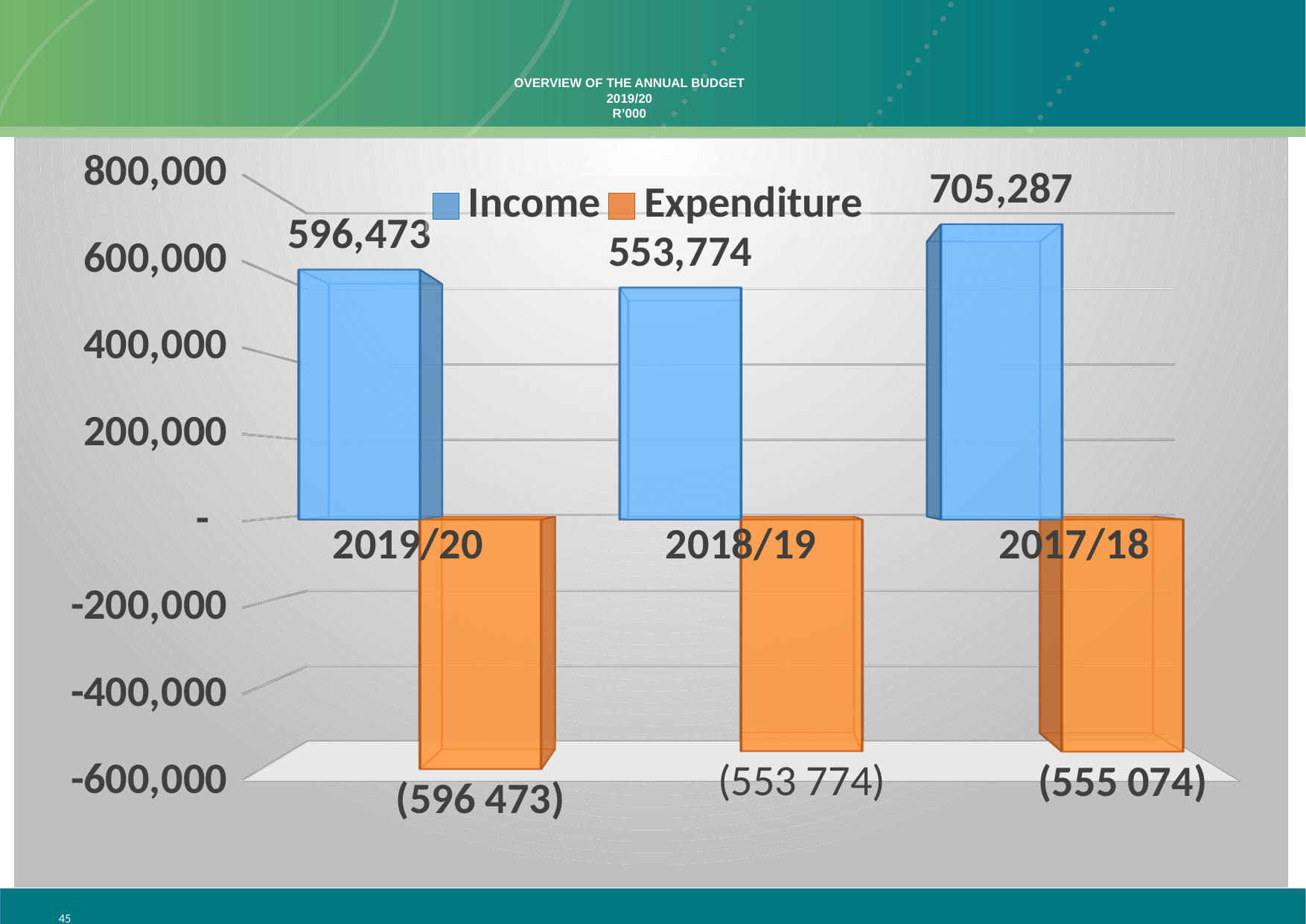
How many series does the legend list? 2 What is the Expenditure value shown for 2018/19? (553 774) Is Income higher in 2019/20 or in 2018/19? 2019/20 What is the difference between Income in 2017/18 and Income in 2019/20? 108,814 What is the Income value for 2019/20? 596,473 What is the Expenditure value shown for 2017/18? (555 074) How many years are shown on the x axis? 3 What is the Income value for 2017/18? 705,287 Which year has the highest Income? 2017/18 Which year has the lowest Income? 2018/19 Is the Income value for 2018/19 greater or less than 600,000? less What type of chart is shown on the slide? Bar chart